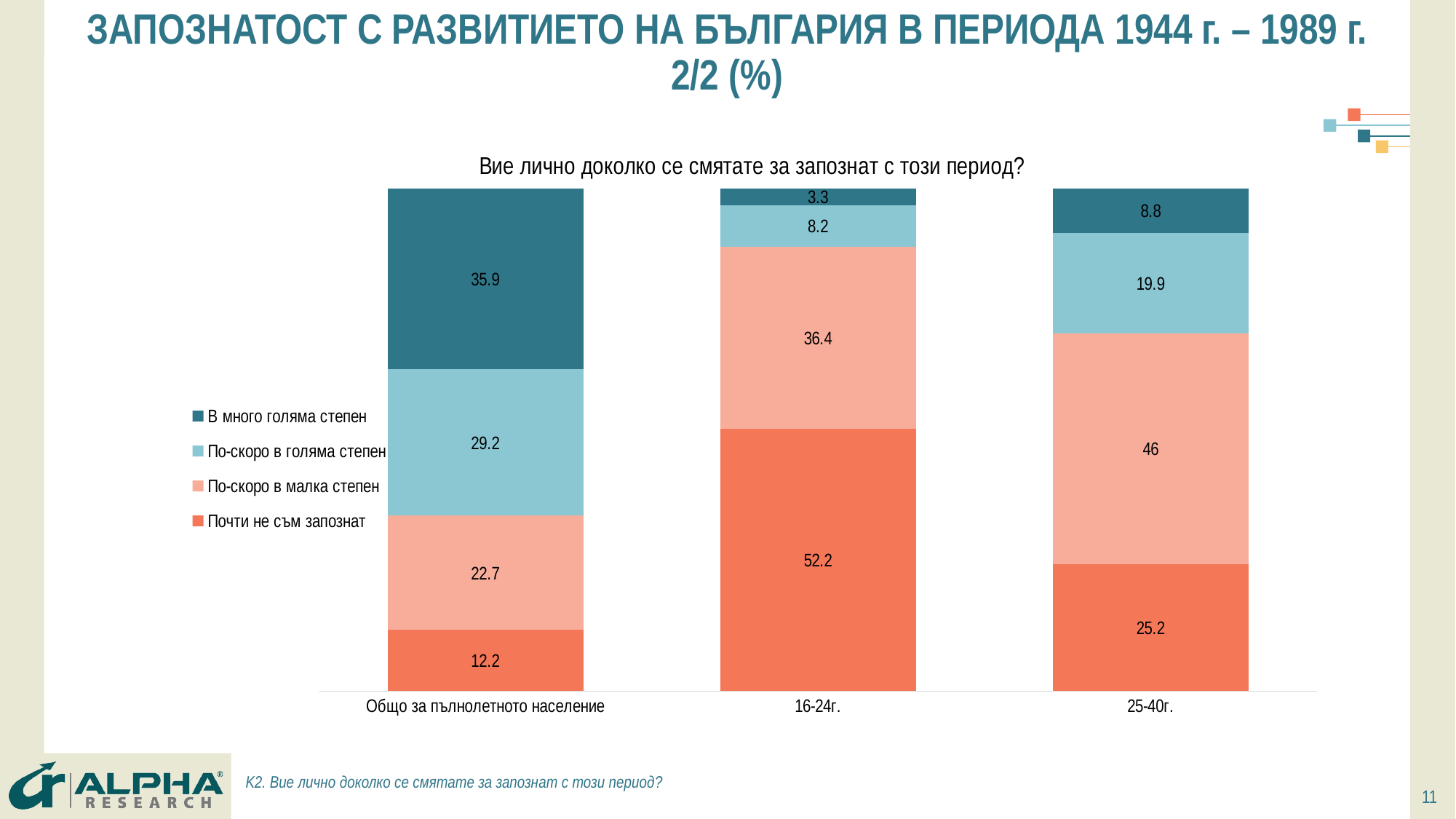
How many categories are shown on the x axis? 3 What is the value of "В много голяма степен" for "Общо за пълнолетното население"? 35.9 What is the question text shown as the chart title? Вие лично доколко се смятате за запознат с този период? Which is larger: "По-скоро в голяма степен" for "Общо за пълнолетното население" or for 25-40г.? Общо за пълнолетното население What is the value of "Почти не съм запознат" for the 16-24г. group? 52.2 What is the value of "По-скоро в голяма степен" for the 16-24г. group? 8.2 What is the value of "По-скоро в малка степен" for the 25-40г. group? 46 What type of chart is shown on the slide? Stacked bar chart How many series does the legend list? 4 What is the difference between the "Почти не съм запознат" values for 16-24г. and 25-40г.? 27 Which category has the highest value for "Почти не съм запознат"? 16-24г. Which category has the lowest value for "В много голяма степен"? 16-24г.